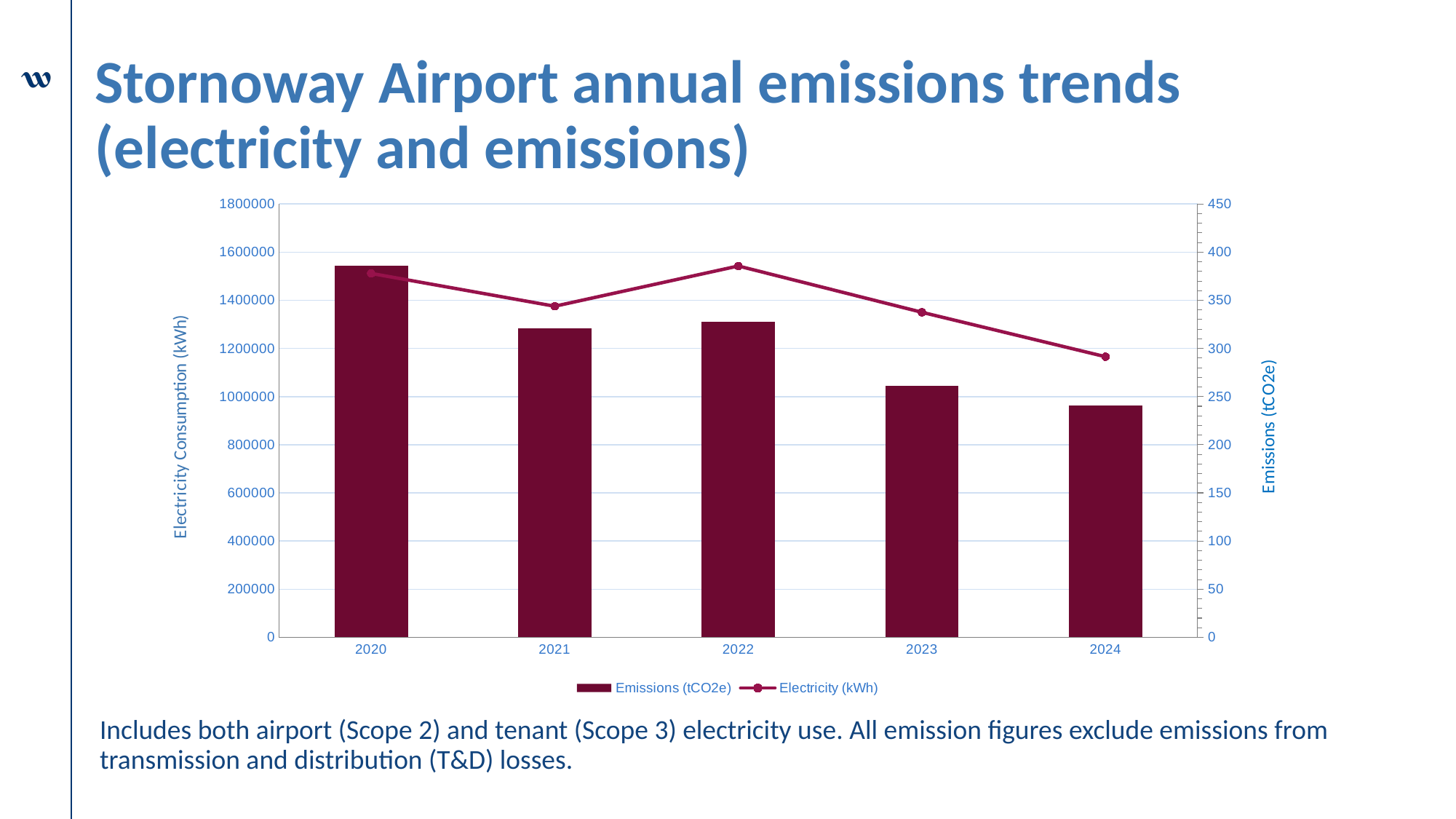
Does the line series rise or fall from 2022 to 2024? Fall In which year does the line series reach its highest point? 2022 Which year has the shortest bar in the chart? 2024 Which bar is taller, 2023 or 2024? 2023 What kind of chart is shown on the slide? Combined bar and line chart Which bar is taller, 2020 or 2024? 2020 Which year has the tallest bar in the chart? 2020 How many series does the chart legend list? 2 How many years are shown on the x axis of the chart? 5 What are the two entries in the chart legend? Emissions (tCO2e) and Electricity (kWh) In which year does the line series reach its lowest point? 2024 What is the title of the chart's left vertical axis? Electricity Consumption (kWh)